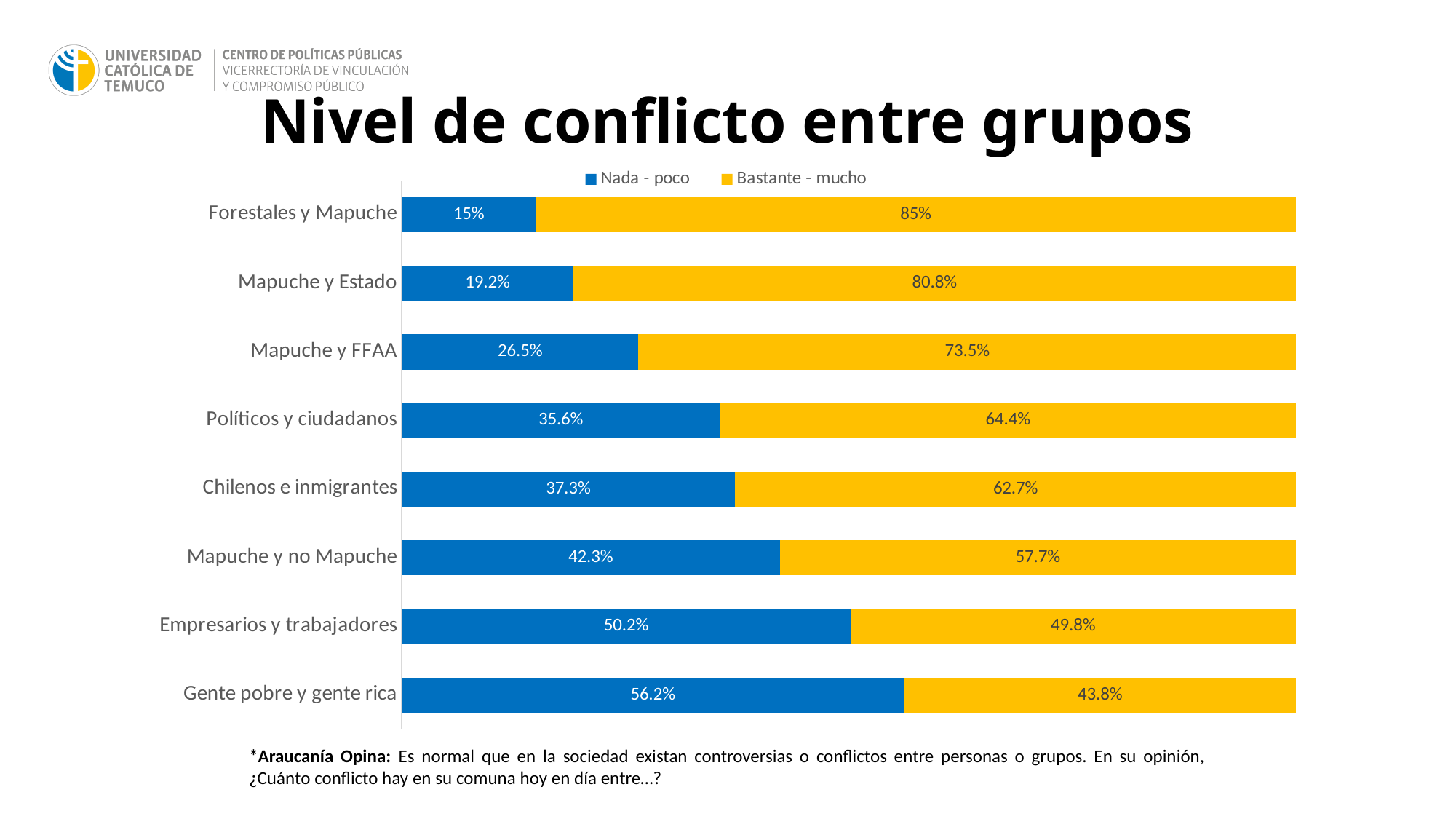
What is the "Bastante - mucho" value for Chilenos e inmigrantes? 62.7% How many categories (group pairs) are shown in the chart? 8 Which category has the lowest "Nada - poco" value? Forestales y Mapuche What is the total of the stacked bar for Empresarios y trabajadores? 100% What kind of chart is shown on the slide? Stacked bar chart Which category has the highest "Bastante - mucho" value? Forestales y Mapuche What is the "Bastante - mucho" value for Forestales y Mapuche? 85% What is the difference between the "Bastante - mucho" values for Mapuche y FFAA and Políticos y ciudadanos? 9.1% Which is larger: the "Nada - poco" value for Mapuche y no Mapuche or for Empresarios y trabajadores? Empresarios y trabajadores How many series does the legend list? 2 What is the "Nada - poco" value for Gente pobre y gente rica? 56.2% What is the "Nada - poco" value for Mapuche y Estado? 19.2%